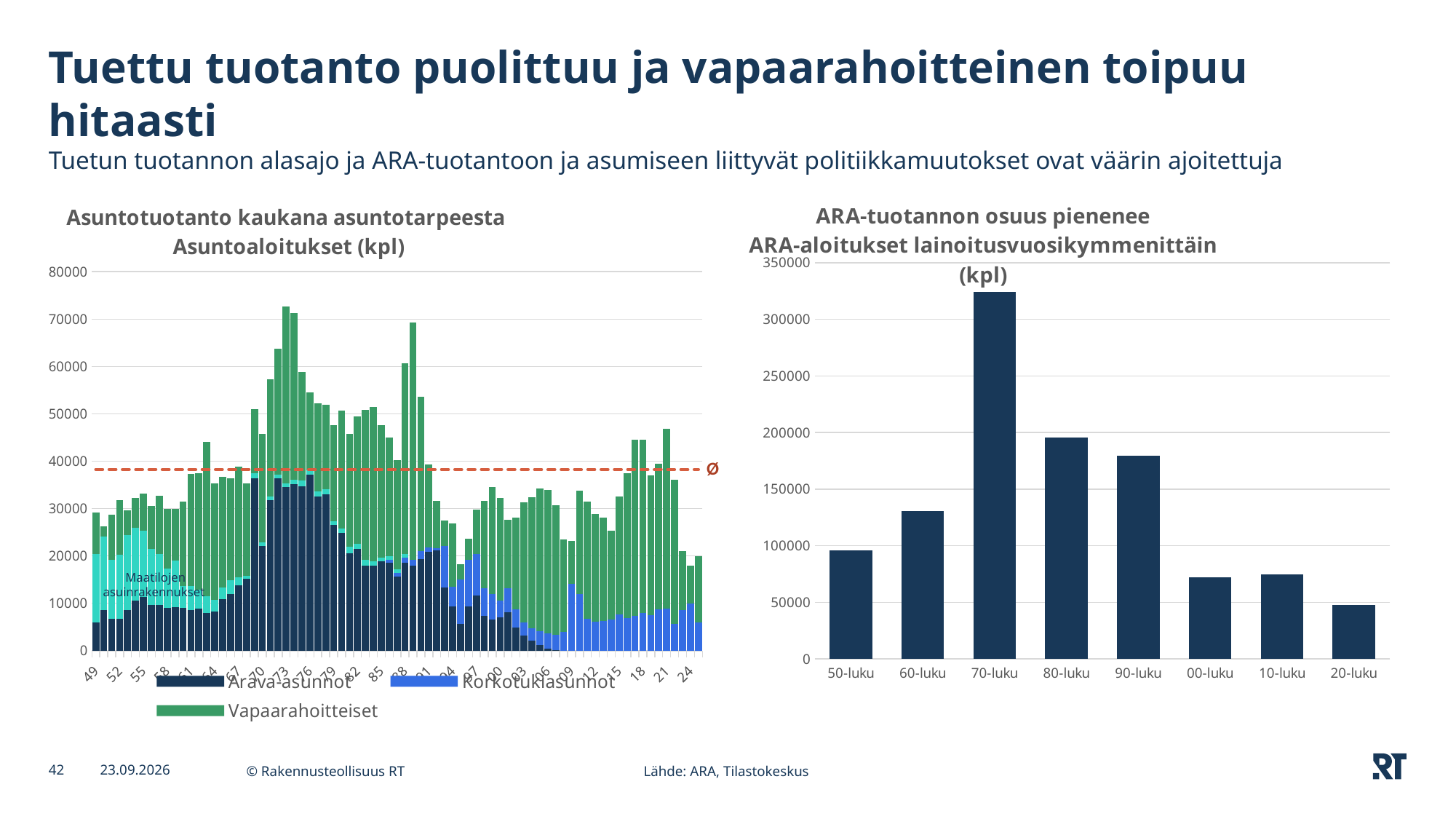
How many decade categories are shown in the chart titled 'ARA-tuotannon osuus pienenee'? 8 In the chart titled 'ARA-tuotannon osuus pienenee', which decade has the highest value? 70-luku In the chart titled 'ARA-tuotannon osuus pienenee', is the value for 70-luku greater or less than 300000? greater What are the legend entries of the chart titled 'Asuntotuotanto kaukana asuntotarpeesta'? Arava-asunnot, Korkotukiasunnot, Vapaarahoitteiset In the chart titled 'ARA-tuotannon osuus pienenee', which is larger, the value for 60-luku or the value for 50-luku? 60-luku How many series does the legend list for the chart titled 'Asuntotuotanto kaukana asuntotarpeesta'? 3 What kind of chart is the chart titled 'ARA-tuotannon osuus pienenee'? Bar chart In the chart titled 'ARA-tuotannon osuus pienenee', which decade has the lowest value? 20-luku In the chart titled 'ARA-tuotannon osuus pienenee', which is larger, the value for 80-luku or the value for 90-luku? 80-luku